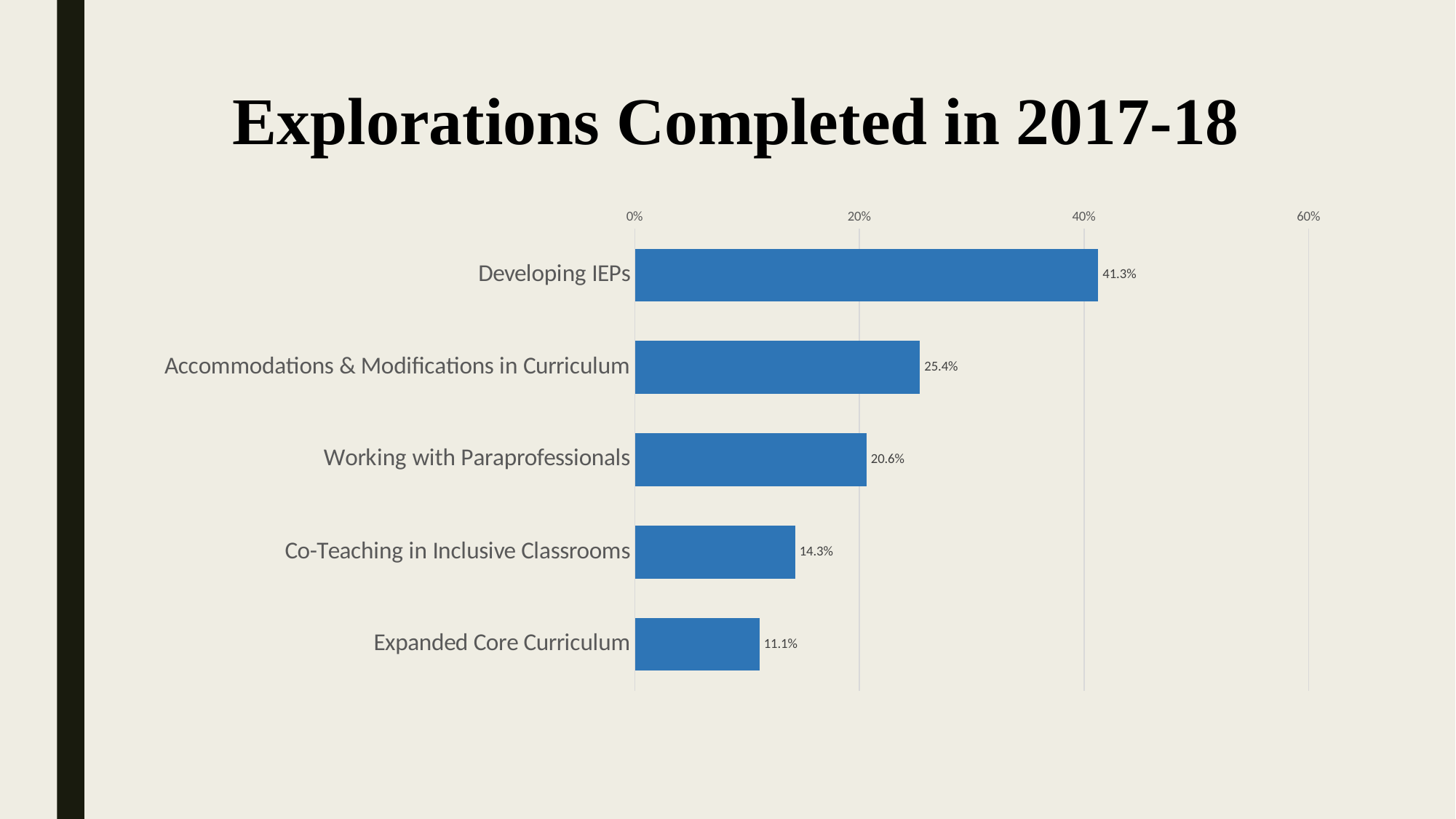
What is the value for Developing IEPs? 41.3% How many categories are shown in the chart? 5 Which category has the highest value? Developing IEPs What kind of chart is shown on the slide? bar chart Which category has the lowest value? Expanded Core Curriculum What is the difference between the values for Developing IEPs and Accommodations & Modifications in Curriculum? 15.9% Which is larger, the value for Working with Paraprofessionals or the value for Co-Teaching in Inclusive Classrooms? Working with Paraprofessionals What is the value for Expanded Core Curriculum? 11.1% What is the value for Co-Teaching in Inclusive Classrooms? 14.3% What is the value for Working with Paraprofessionals? 20.6% What is the value for Accommodations & Modifications in Curriculum? 25.4% Is the value for Developing IEPs greater or less than 40%? greater